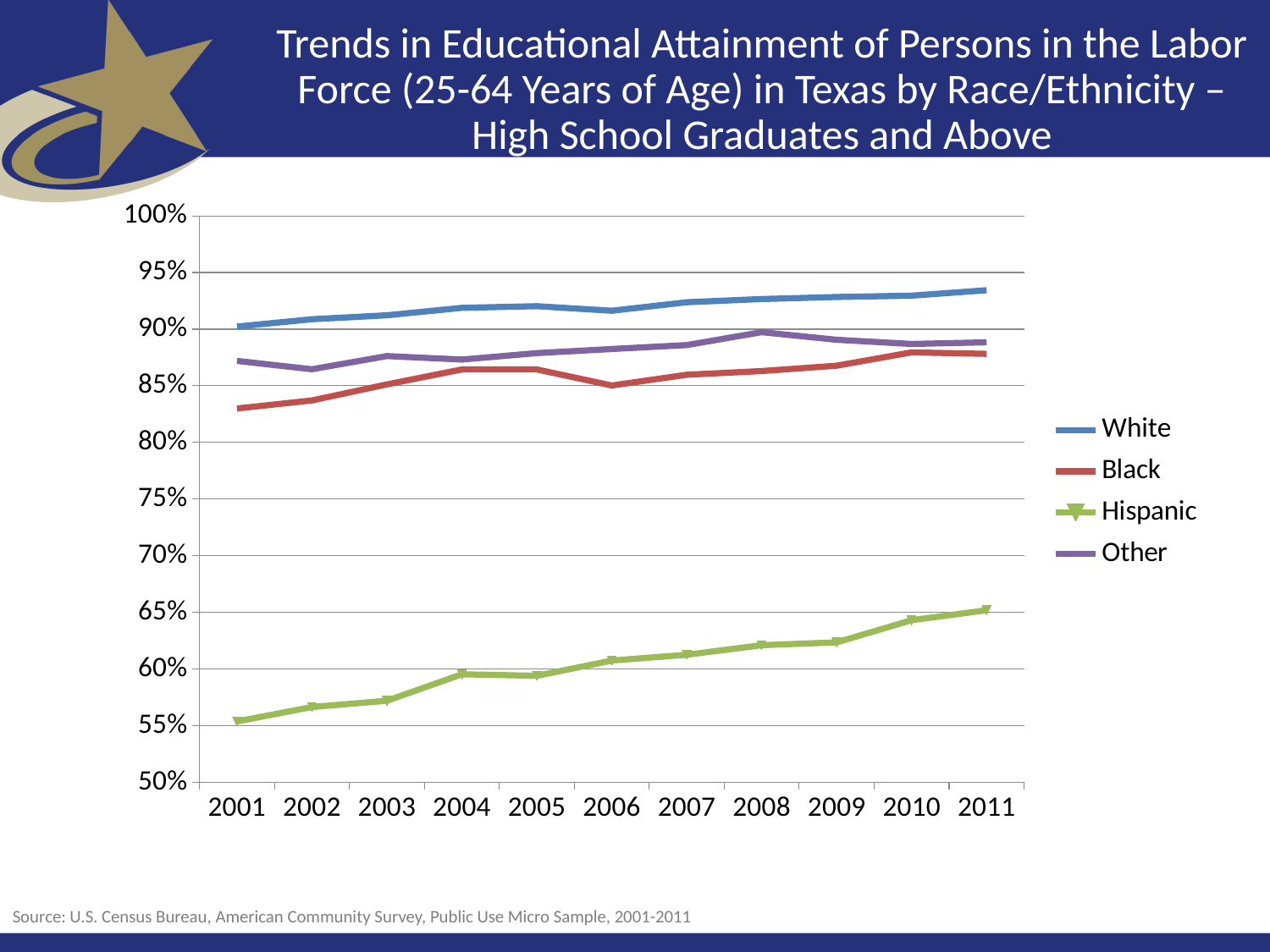
Is the value for Hispanic in 2001 greater or less than 60%? less Is the value for White in 2011 greater or less than 90%? greater How many series does the legend list? 4 How many years are shown along the x axis? 11 In 2006, which is larger, the value for Black or the value for Other? Other Does the Hispanic series generally rise or fall from 2001 to 2011? rise What kind of chart is shown on the slide? line chart What colour is the line for the Hispanic series? green Is the value for Black in 2001 greater or less than 85%? less Which series has the lowest values across the chart? Hispanic Which series has the highest values across the chart? White